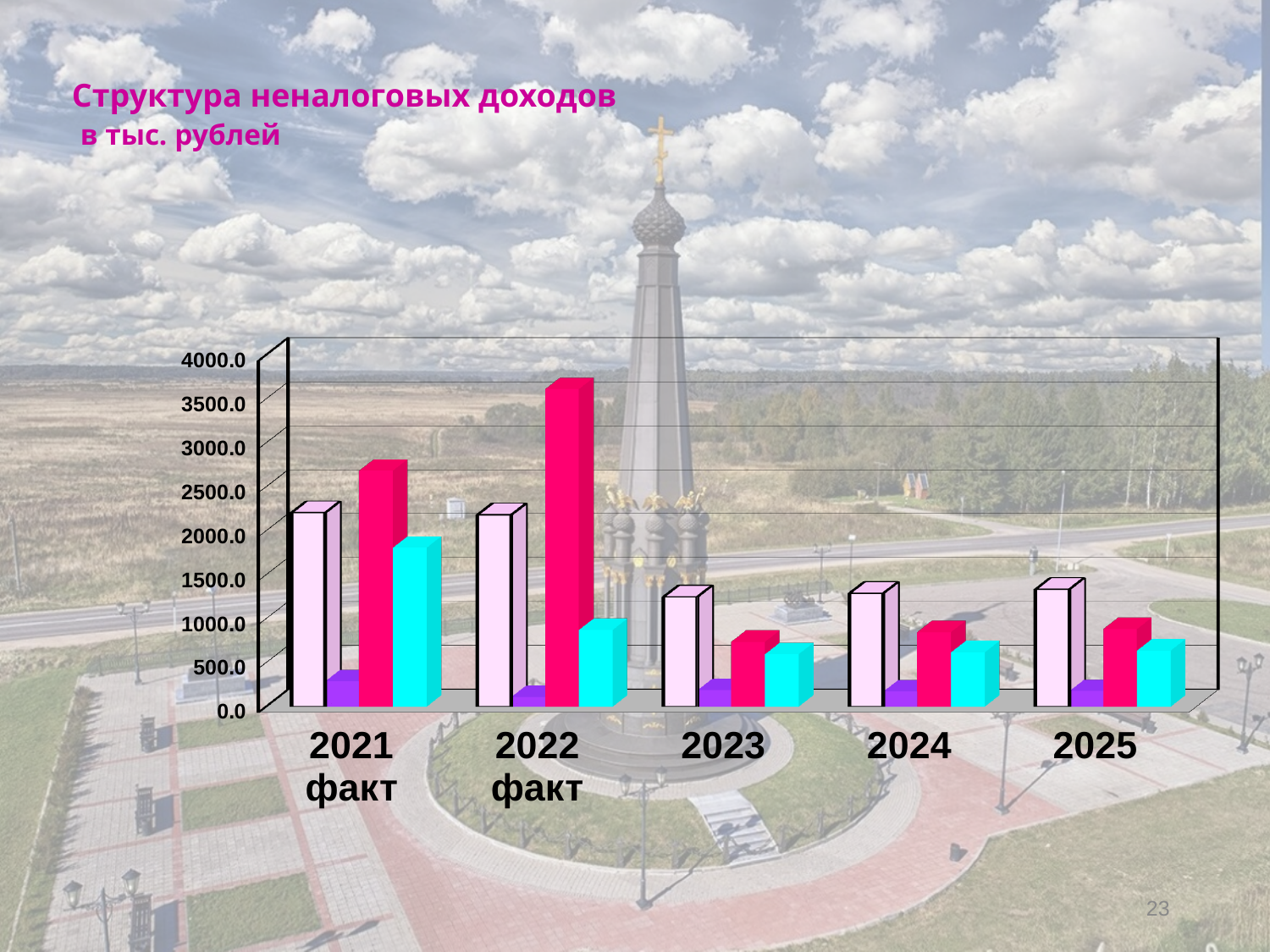
Is the light pink bar for 2023 greater or less than 2000? less What is the highest value shown on the vertical axis of the chart? 4000.0 Which is larger: the light pink bar for 2021 факт or the light pink bar for 2024? 2021 факт Is the purple bar for 2021 факт greater or less than 500? less Is the cyan bar for 2022 факт greater or less than 1500? less What kind of chart is shown on the slide? bar chart Which is larger: the magenta bar for 2021 факт or the magenta bar for 2022 факт? 2022 факт How many categories are shown along the x axis of the chart? 5 What is the title of the chart on the slide? Структура неналоговых доходов в тыс. рублей In which category does the tallest bar of the whole chart appear? 2022 факт